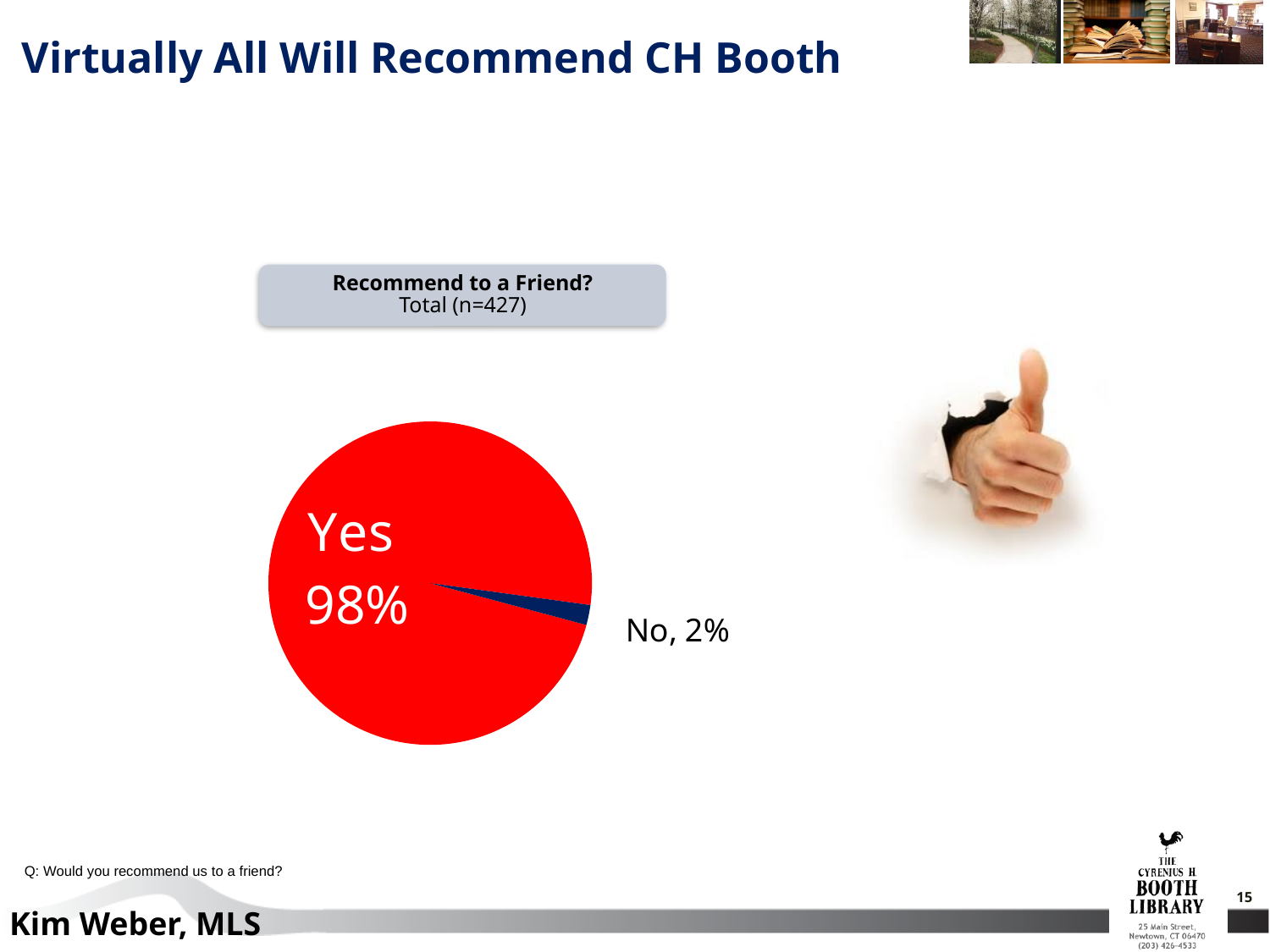
What is the sample size (n) shown above the pie chart? 427 Which response has the smallest share of the pie? No Which is larger, the Yes share or the No share? Yes What is the combined share of the Yes and No slices? 100% Which response has the largest share of the pie? Yes How many slices does the pie chart have? 2 What percentage of respondents answered Yes to recommending to a friend? 98% What is the title shown in the box above the pie chart? Recommend to a Friend? What kind of chart is shown on the slide? pie chart What is the difference in percentage points between the Yes and No shares? 96 What percentage of respondents answered No? 2%